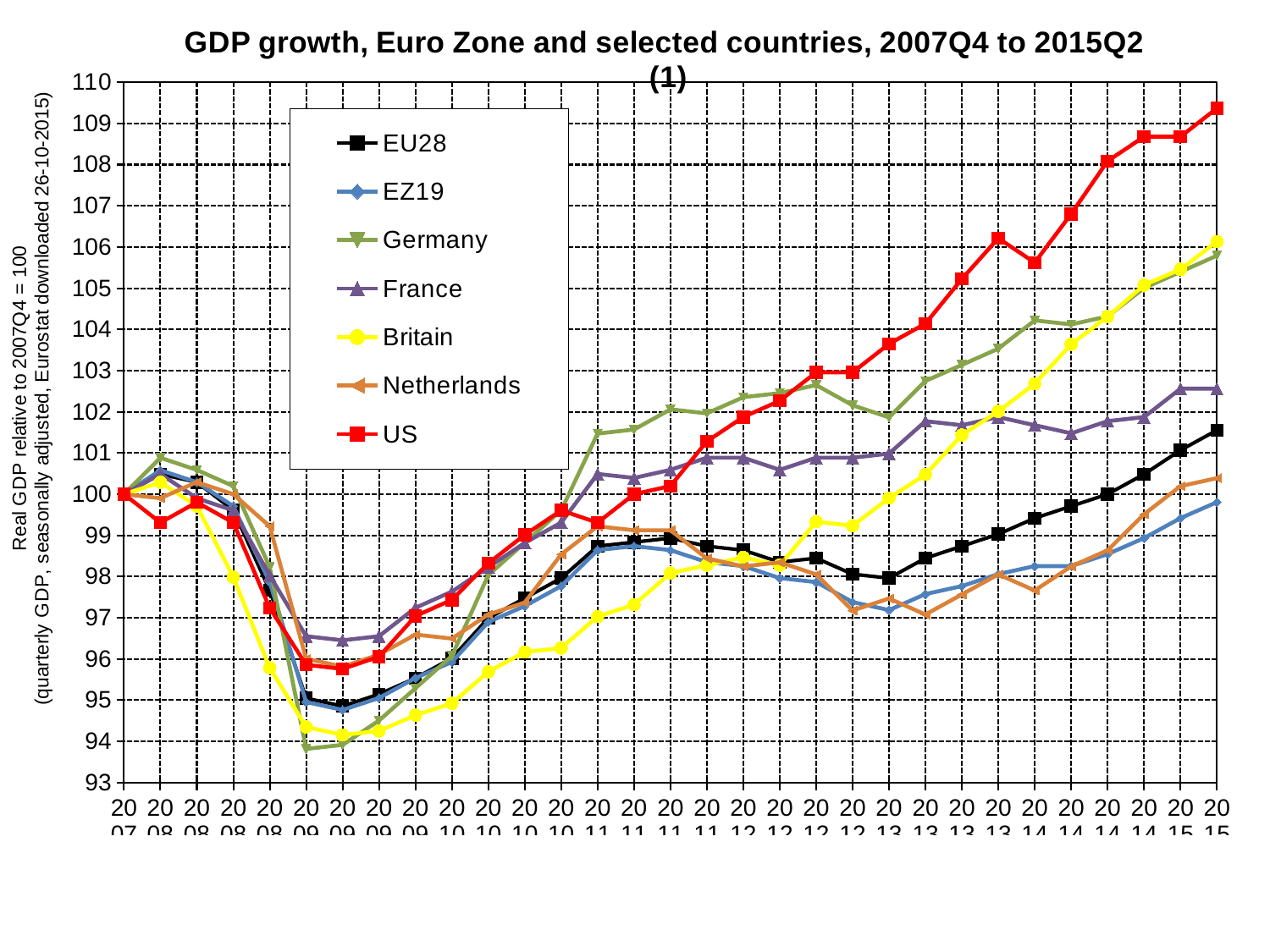
What value do all series share at the first point of the chart (2007Q4)? 100 At the end of the period (2015Q2), which is larger, the value for France or the value for EU28? France What is the title of the chart? GDP growth, Euro Zone and selected countries, 2007Q4 to 2015Q2 (1) Which series has the highest value at the end of the period (2015Q2)? US Does the US series rise or fall from 2012 to the end of the period? rise What kind of chart is shown on the slide? line chart Is the lowest value reached by Britain greater or less than 95? less At the end of the period (2015Q2), which is larger, the value for US or the value for Germany? US What colour is the US series in the legend? red Is the value for US at the end of the period (2015Q2) greater or less than 108? greater Is the value for Britain at the end of the period (2015Q2) greater or less than 105? greater How many series does the legend list? 7